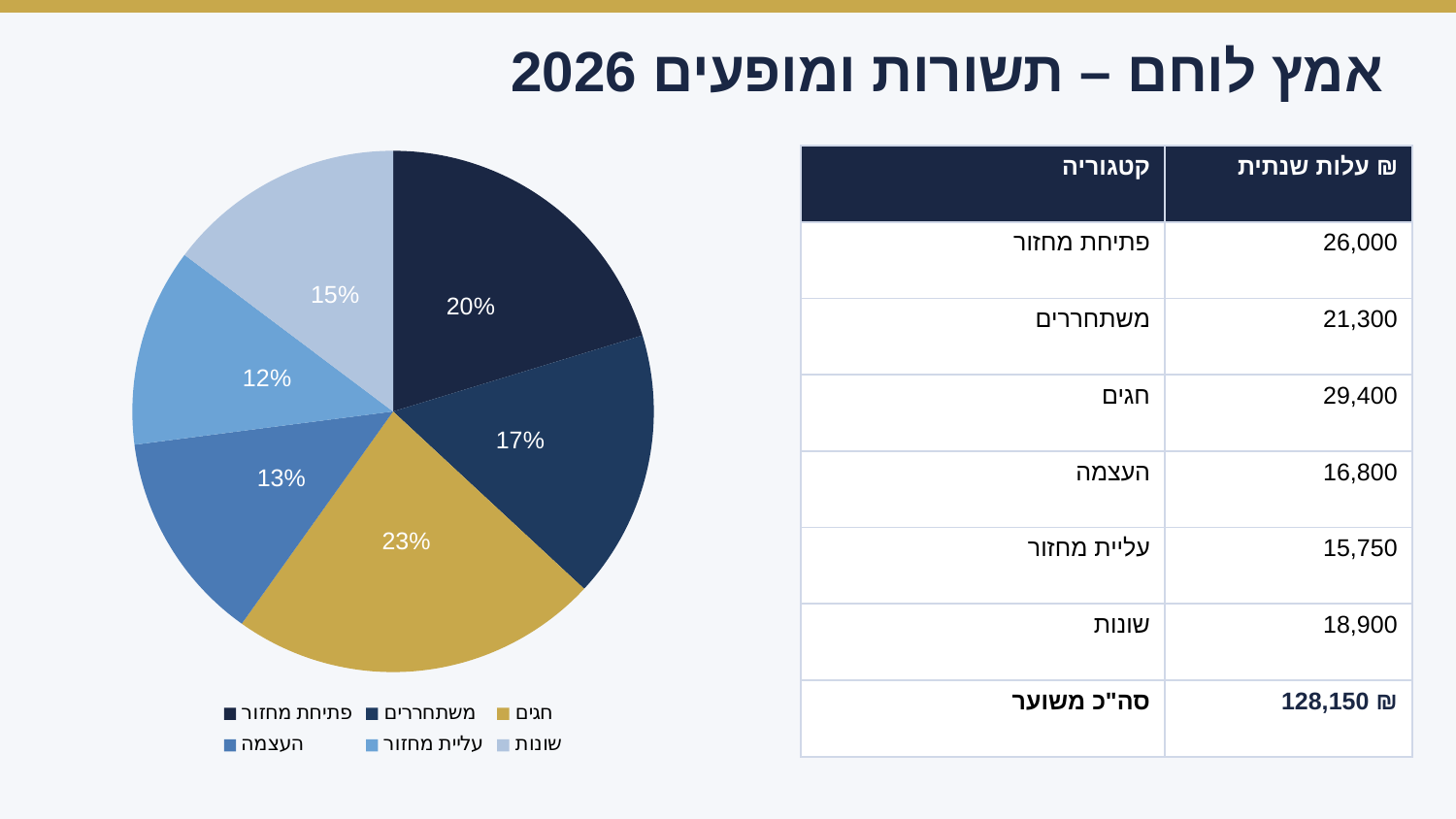
What share of the pie does העצמה represent? 13% Which slice is larger, פתיחת מחזור or שונות? פתיחת מחזור What share of the pie does שונות represent? 15% What is the difference in percentage points between the חגים slice and the עליית מחזור slice? 11% What kind of chart is shown on the slide? pie chart Which category has the smallest slice of the pie? עליית מחזור What share of the pie does חגים represent? 23% What share of the pie does פתיחת מחזור represent? 20% What share of the pie does משתחררים represent? 17% How many slices does the pie chart have? 6 Which category has the largest slice of the pie? חגים What share of the pie does עליית מחזור represent? 12%